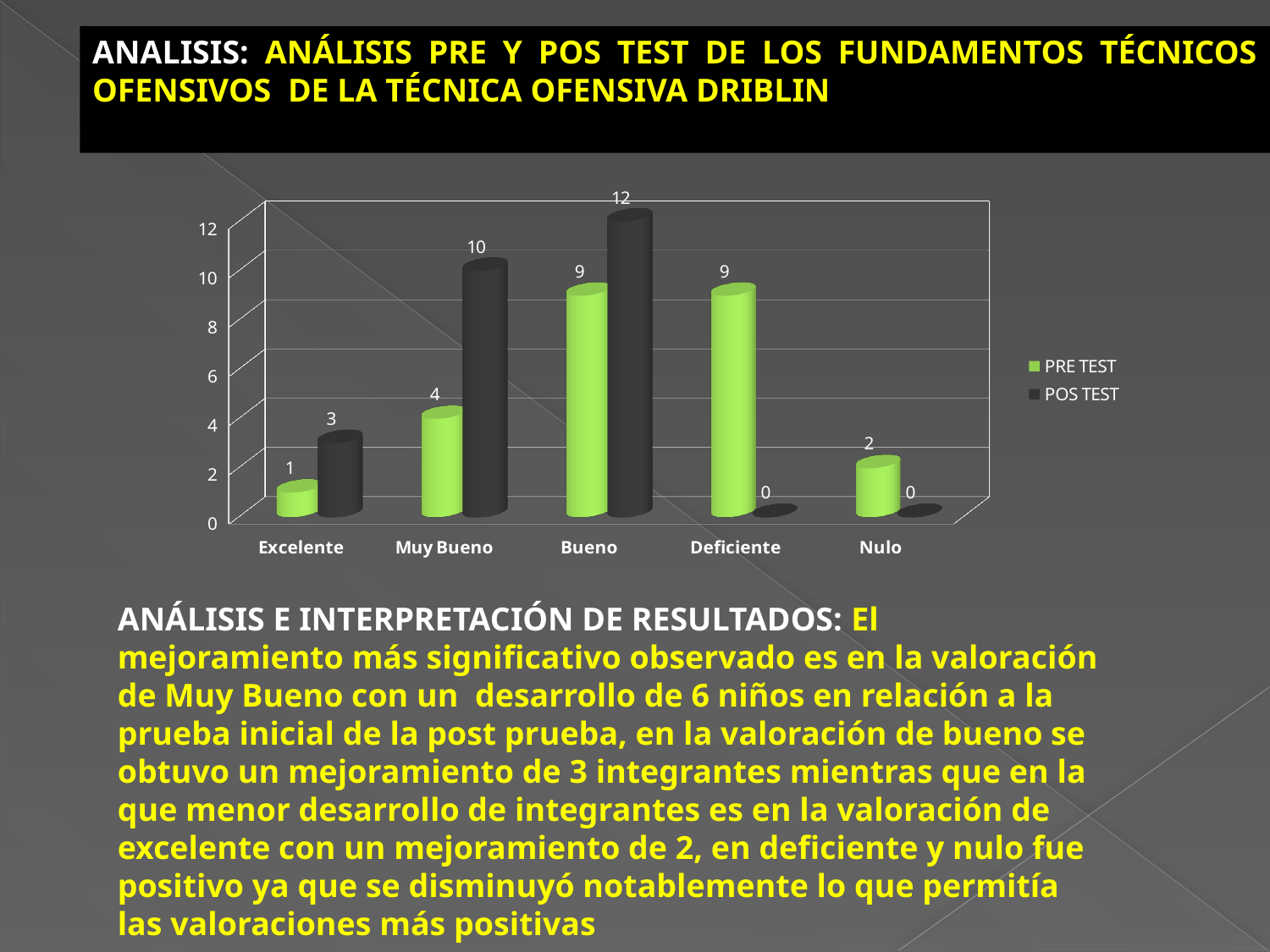
What is the PRE TEST value for Deficiente? 9 What is the POS TEST value for Nulo? 0 What is the PRE TEST value for Muy Bueno? 4 What is the POS TEST value for Bueno? 12 What is the difference between the POS TEST and PRE TEST values for Muy Bueno? 6 Which category has the lowest PRE TEST value? Excelente What kind of chart is shown on the slide? Bar chart How many categories are shown on the x axis? 5 Which colour represents the PRE TEST series? Green How many series does the legend list? 2 Which category has the highest POS TEST value? Bueno Which is larger for Excelente, the PRE TEST value or the POS TEST value? POS TEST